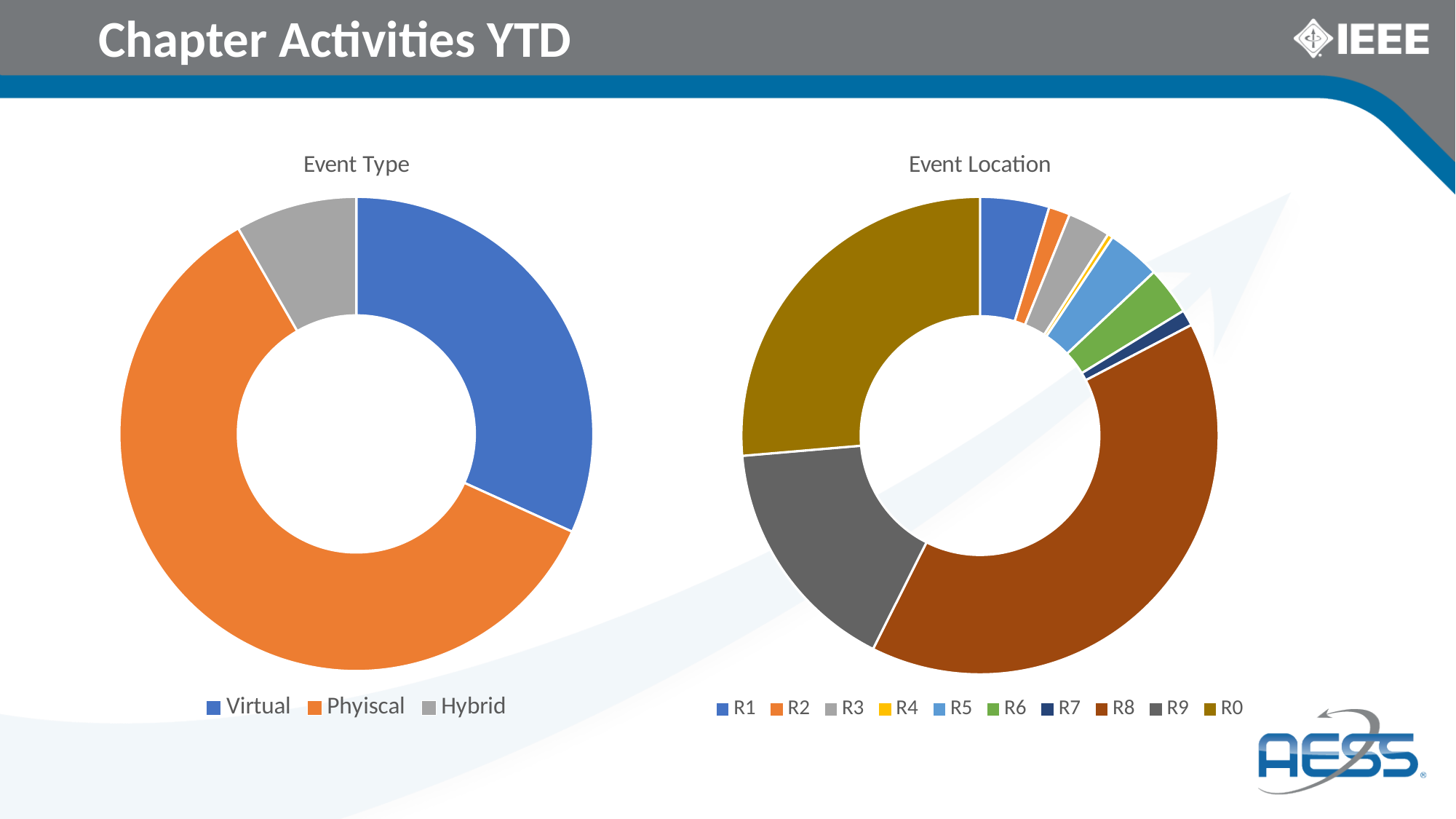
In the Event Location chart, which region has the smallest slice? R4 What kind of chart is the Event Type chart? Doughnut (pie) chart What kind of chart is the Event Location chart? Doughnut (pie) chart In the Event Type chart, which category has the smallest slice? Hybrid In the Event Type chart, which category has the largest slice? Phyiscal In the Event Type chart, how many categories does the legend list? 3 In the Event Location chart, which slice is larger, R1 or R2? R1 In the Event Location chart, which region has the largest slice? R8 What is the title of the chart on the right side of the slide? Event Location In the Event Type chart, which slice is larger, Virtual or Hybrid? Virtual In the Event Location chart, how many categories does the legend list? 10 In the Event Location chart, which slice is larger, R0 or R9? R0